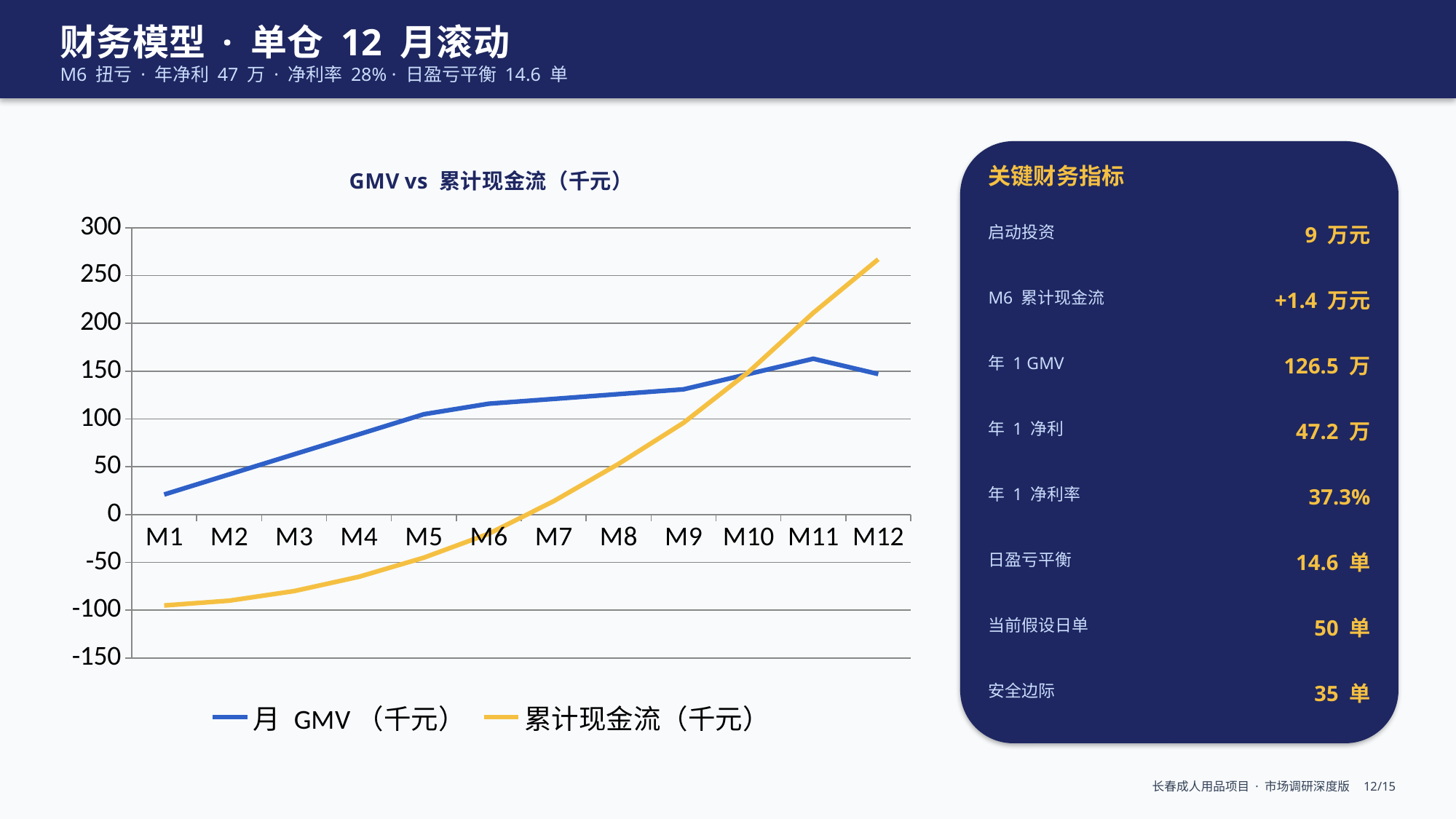
Is the value of 月 GMV（千元） at M1 greater or less than 50? less Is the value of 累计现金流（千元） at M12 greater or less than 250? greater How many months are plotted along the x axis of the chart? 12 How many series does the chart legend list? 2 What kind of chart is shown on the slide? line chart Is the value of 累计现金流（千元） at M1 greater or less than -50? less At M12, which series has the higher value, 月 GMV（千元） or 累计现金流（千元）? 累计现金流（千元） Does 累计现金流（千元） rise or fall from M1 to M12? rise What is the title of the chart? GMV vs 累计现金流（千元） In which month does 月 GMV（千元） reach its highest value? M11 In which month is 月 GMV（千元） lowest? M1 In which month is 累计现金流（千元） highest? M12